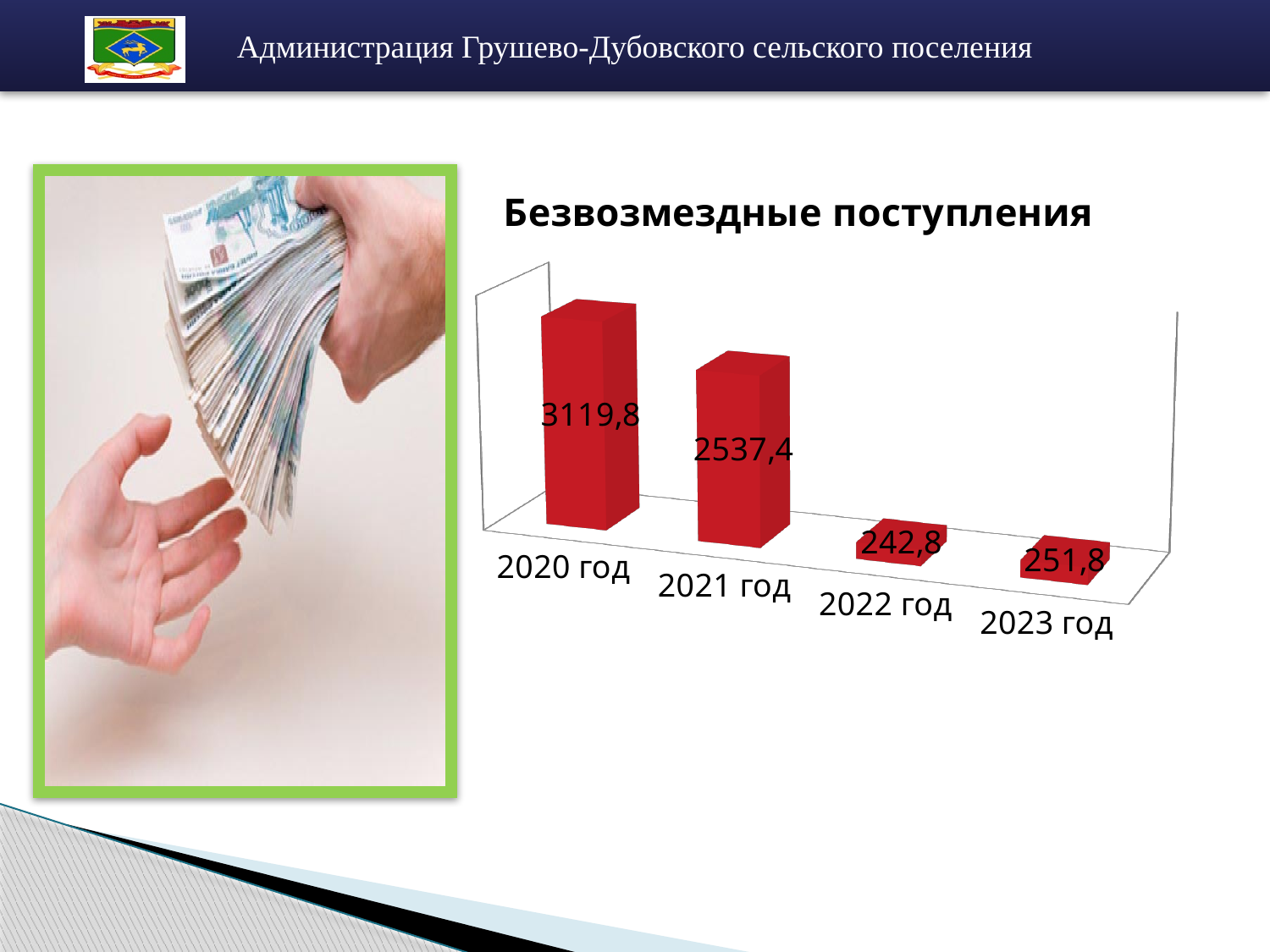
Which is larger in the Безвозмездные поступления chart, the value for 2022 год or 2023 год? 2023 год Do the values in the Безвозмездные поступления chart rise or fall from 2020 год to 2022 год? Fall What kind of chart is the Безвозмездные поступления chart? Bar chart What is the value for 2021 год in the Безвозмездные поступления chart? 2537,4 What is the difference between the values for 2023 год and 2022 год in the Безвозмездные поступления chart? 9 What is the value for 2023 год in the Безвозмездные поступления chart? 251,8 Which year has the lowest value in the Безвозмездные поступления chart? 2022 год What is the value for 2022 год in the Безвозмездные поступления chart? 242,8 Which year has the highest value in the Безвозмездные поступления chart? 2020 год What is the difference between the values for 2020 год and 2021 год in the Безвозмездные поступления chart? 582,4 How many years are shown in the Безвозмездные поступления chart? 4 What is the value for 2020 год in the Безвозмездные поступления chart? 3119,8